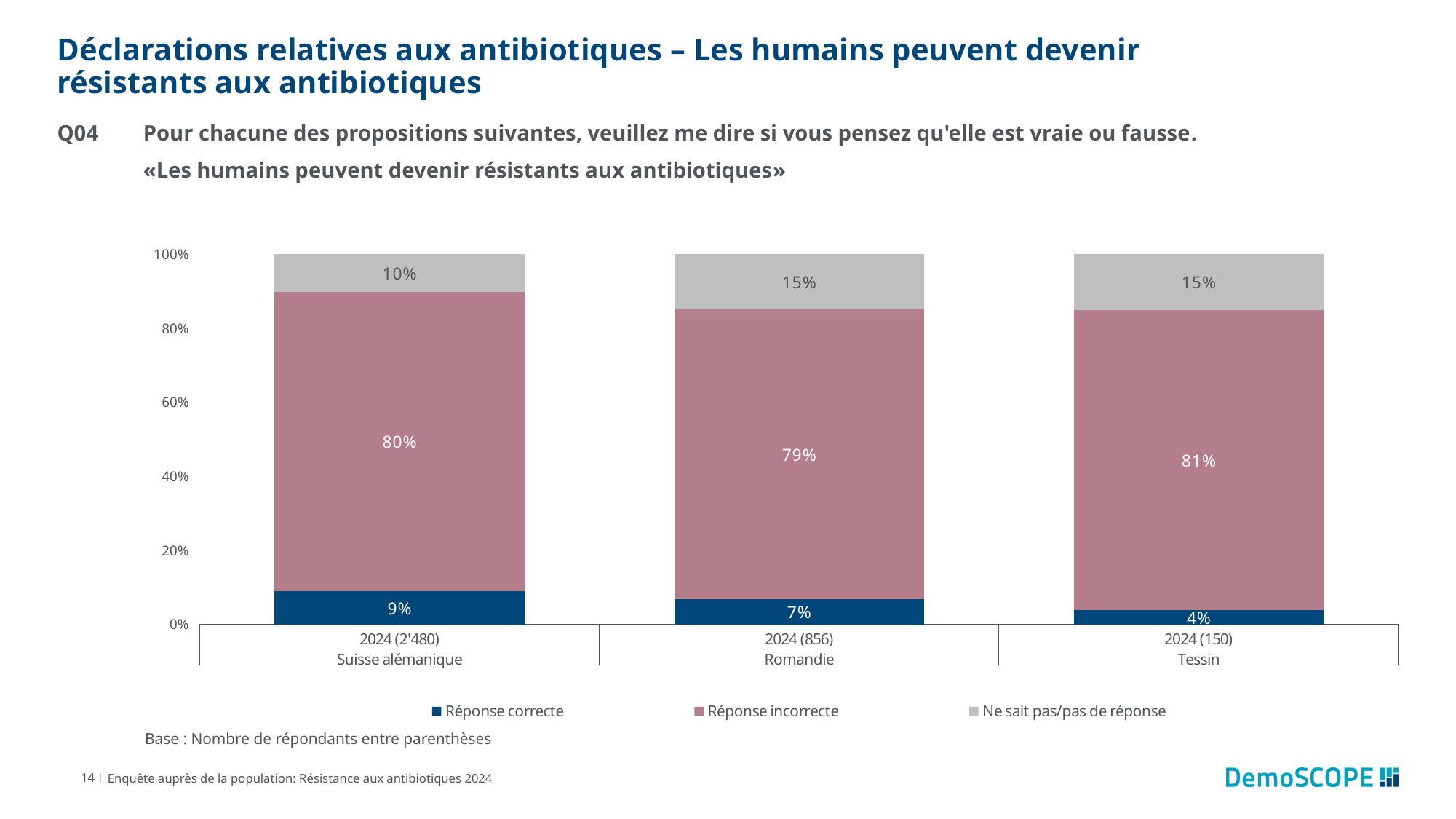
Which is larger: 'Ne sait pas/pas de réponse' for Suisse alémanique or for Romandie? Romandie What is the value of 'Ne sait pas/pas de réponse' for Tessin? 15% Is the value for 'Réponse incorrecte' in Tessin greater or less than 60%? greater What is the value of 'Réponse incorrecte' for Romandie? 79% What is the difference between the 'Réponse correcte' values for Suisse alémanique and Tessin? 5% What is the value of 'Réponse correcte' for Suisse alémanique? 9% How many regions are shown on the x axis? 3 Which region has the lowest value for 'Réponse correcte'? Tessin How many series does the legend list? 3 What kind of chart is shown on the slide? Stacked bar chart What is the number of respondents shown in parentheses for Romandie? 856 Which region has the highest value for 'Réponse correcte'? Suisse alémanique